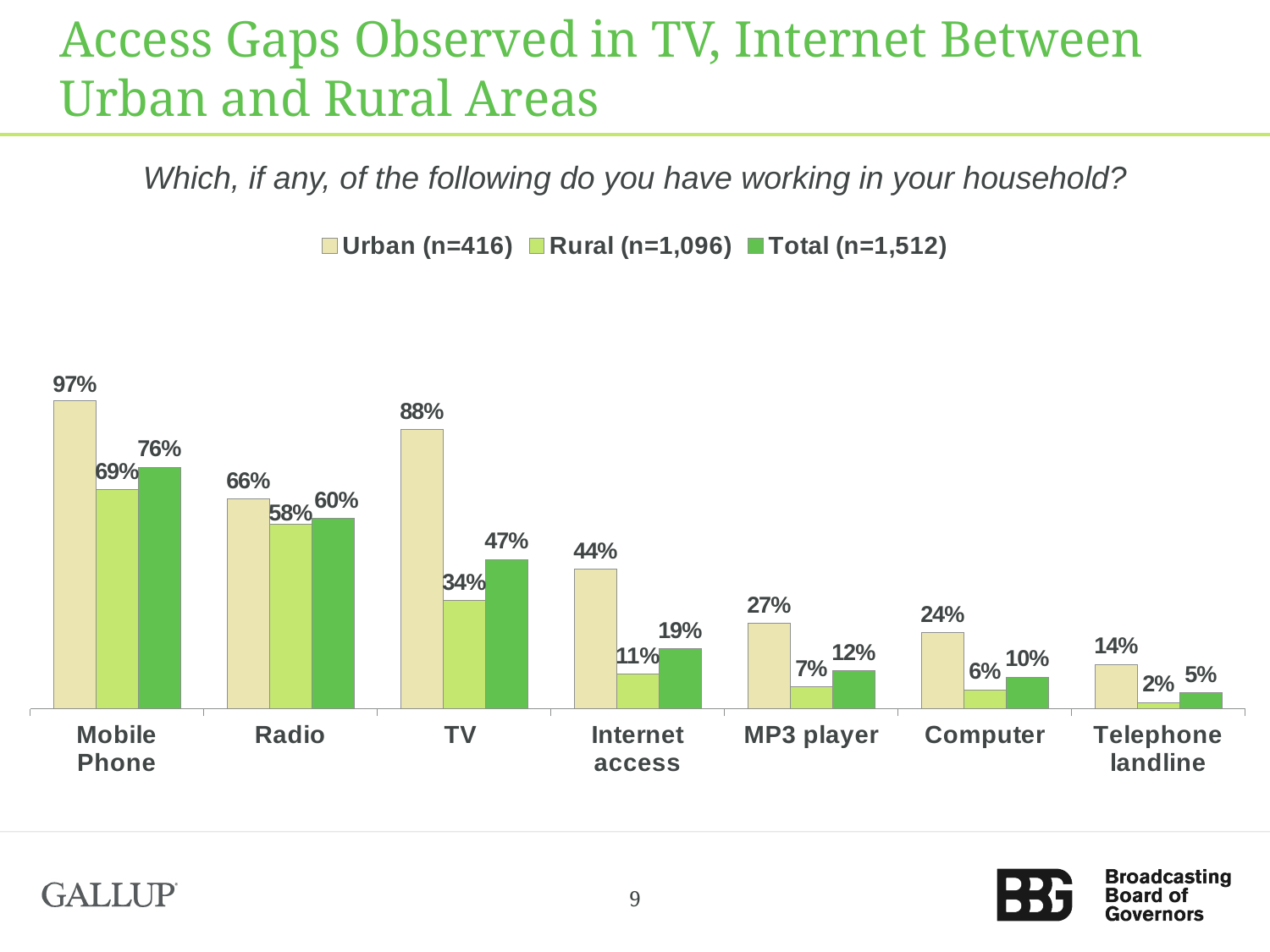
What is the Rural value for Telephone landline? 2% What is the Urban value for Mobile Phone? 97% What is the difference between the Urban and Rural values for Internet access? 33% What kind of chart is shown on the slide? Bar chart What is the Total value for Internet access? 19% Which category has the lowest Total value? Telephone landline How many series does the legend list? 3 Which is larger, the Rural value for Radio or the Rural value for Mobile Phone? Rural value for Mobile Phone How many categories are shown on the x axis? 7 Which category has the highest Urban value? Mobile Phone What is the Rural value for TV? 34% What is the difference between the Urban and Rural values for TV? 54%